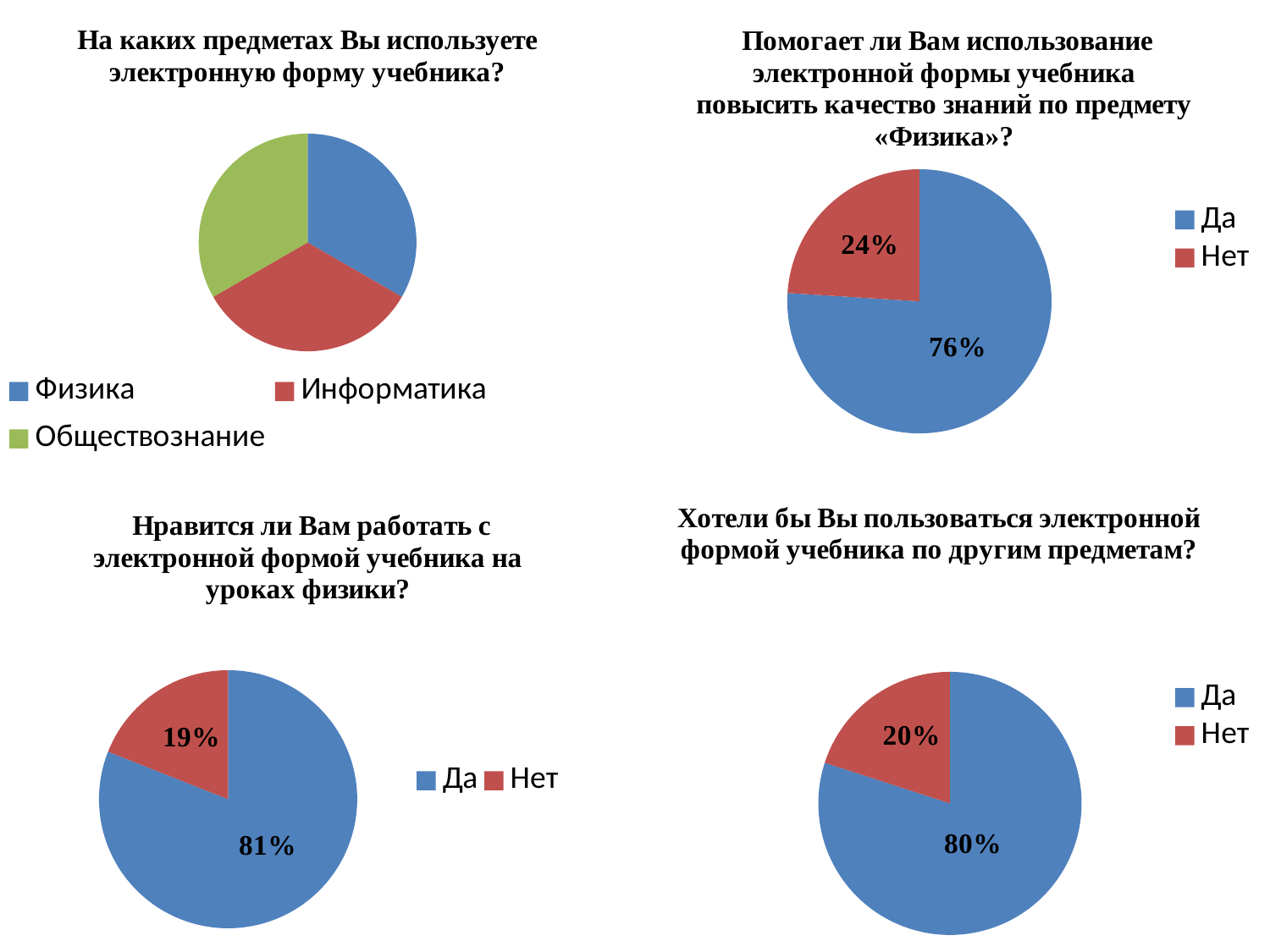
In the bottom-left pie chart ("Нравится ли Вам работать с электронной формой учебника на уроках физики?"), what percentage answered "Да"? 81% What are the legend entries of the top-left pie chart? Физика, Информатика, Обществознание In the top-right pie chart, what percentage answered "Нет"? 24% What type of chart is used in the top-left chart on the slide? Pie chart In the bottom-right pie chart, which answer has the smallest share? Нет In the top-right pie chart, which answer has the largest share? Да How many categories does the top-left pie chart ("На каких предметах Вы используете электронную форму учебника?") show? 3 In the bottom-left pie chart, what is the difference between the "Да" and "Нет" shares? 62% In the bottom-right pie chart ("Хотели бы Вы пользоваться электронной формой учебника по другим предметам?"), what percentage answered "Да"? 80% In the bottom-left pie chart, what percentage answered "Нет"? 19% In the bottom-right pie chart, what percentage answered "Нет"? 20% In the top-right pie chart ("Помогает ли Вам использование электронной формы учебника повысить качество знаний по предмету «Физика»?"), what percentage answered "Да"? 76%